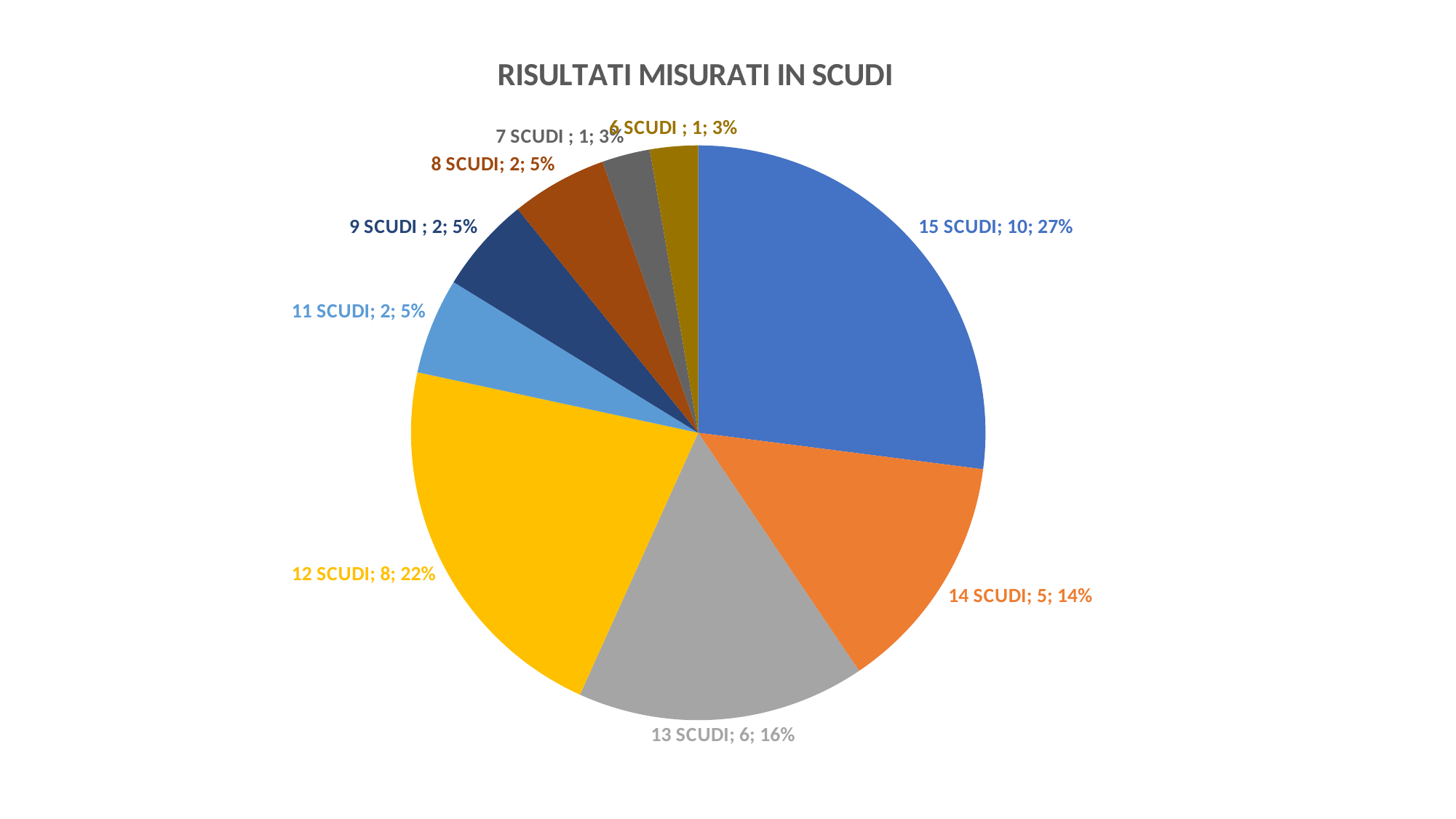
What type of chart is shown on the slide? Pie chart Which category has the largest slice? 15 SCUDI Which is larger, the value for 13 SCUDI or the value for 14 SCUDI? 13 SCUDI What is the difference between the values for 15 SCUDI and 12 SCUDI? 2 What is the value for 15 SCUDI? 10 What is the title of the chart? RISULTATI MISURATI IN SCUDI How many slices does the pie chart have? 9 What is the value for 13 SCUDI? 6 What is the percentage share of the 14 SCUDI slice? 14% What percentage share does the 7 SCUDI slice have? 3% What percentage share does the 12 SCUDI slice have? 22% What is the value for 8 SCUDI? 2